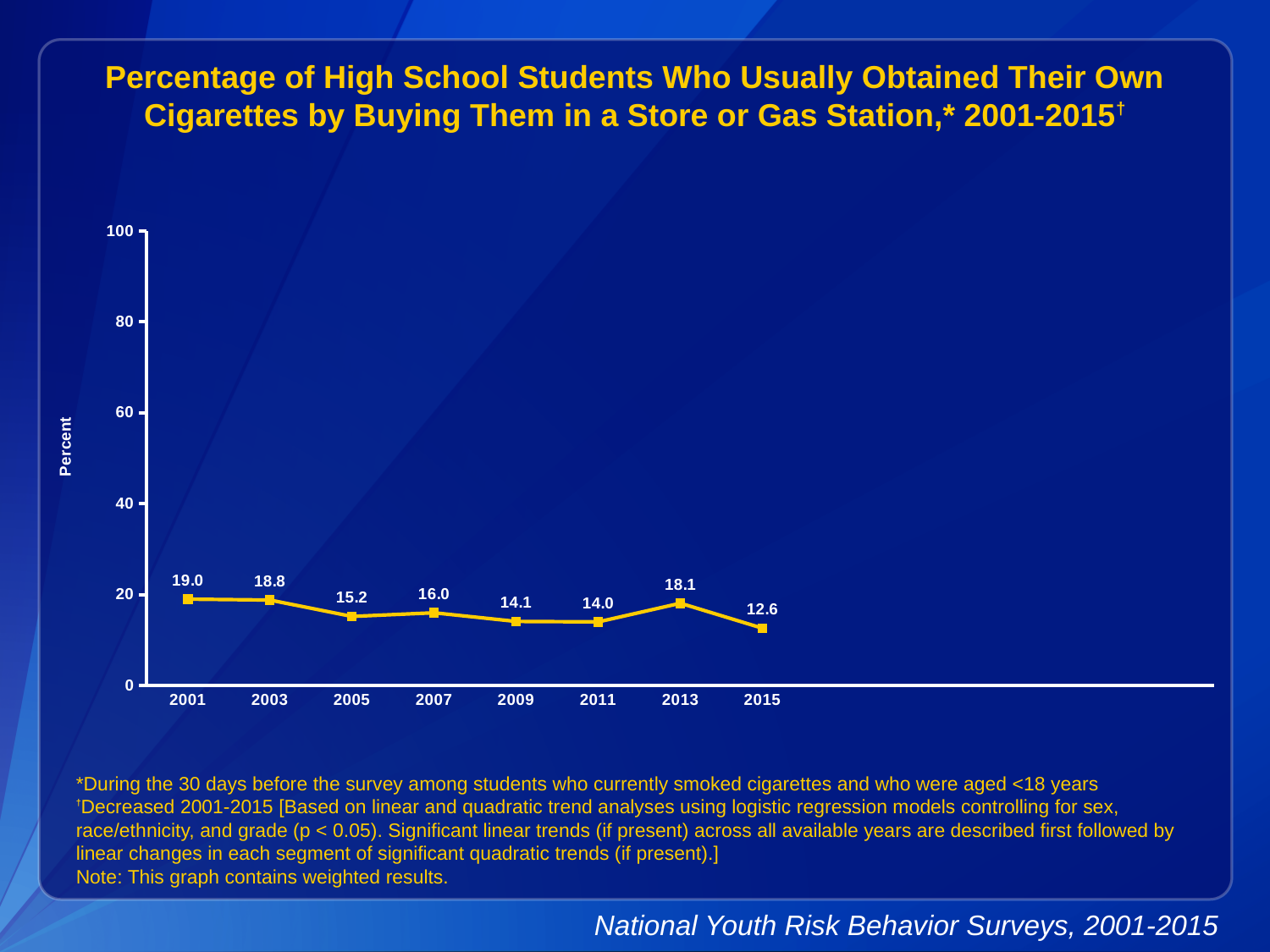
What is the value for 2013? 18.1 What kind of chart is shown? line chart What is the label on the y axis? Percent Do the values generally rise or fall from 2001 to 2015? fall Which year has the highest value? 2001 Which is larger, the value for 2005 or the value for 2007? 2007 What is the difference between the values for 2001 and 2015? 6.4 What is the value for 2001? 19.0 Which year has the lowest value? 2015 How many years are plotted on the x axis? 8 Is the value for 2009 greater or less than 20? less What is the value for 2015? 12.6